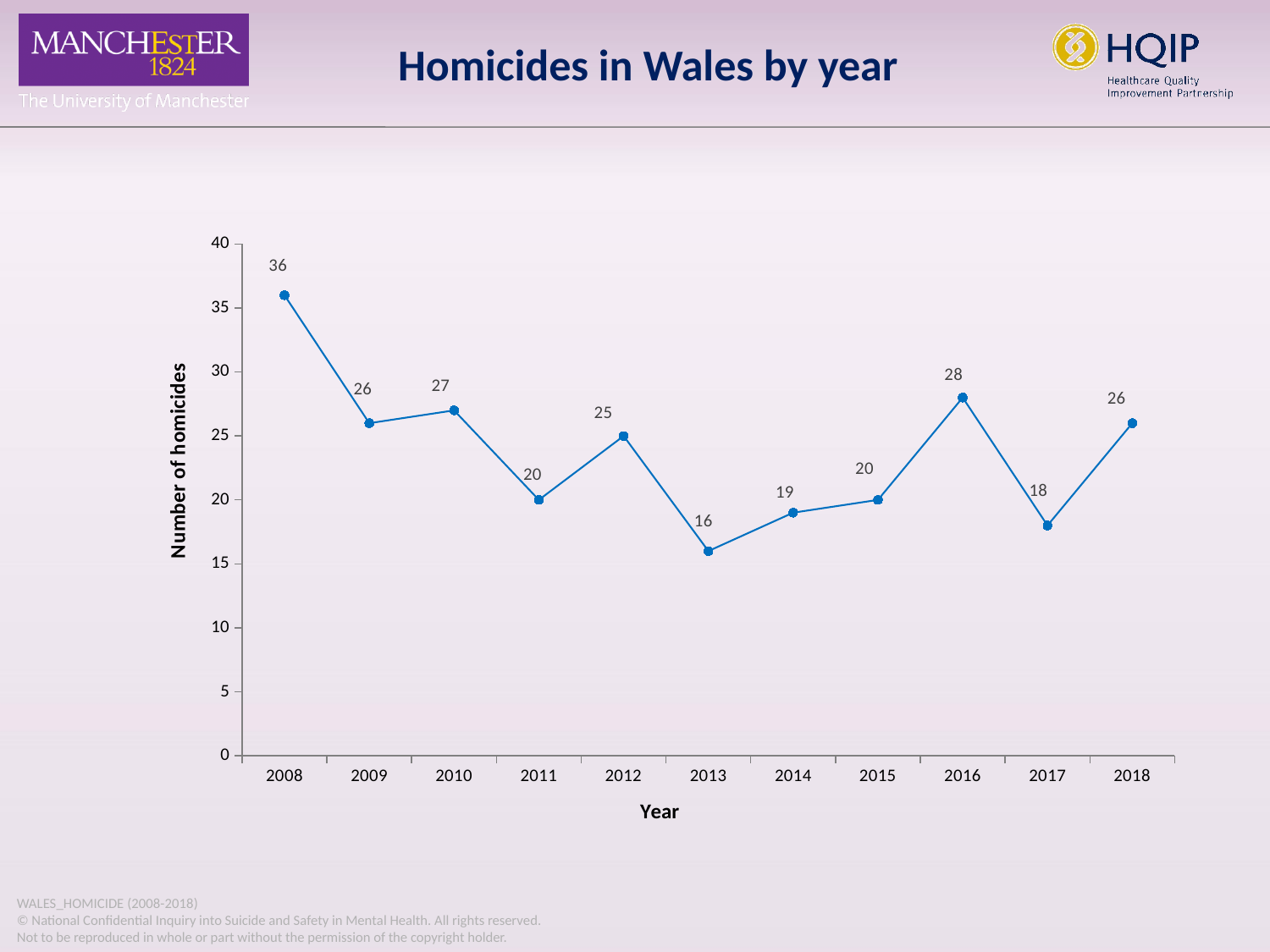
How many years are plotted on the chart? 11 Which year has the lowest number of homicides? 2013 What is the number of homicides in Wales in 2016? 28 What is the number of homicides in Wales in 2008? 36 What is the difference in the number of homicides between 2008 and 2013? 20 Which year has the highest number of homicides? 2008 What is the label of the y axis? Number of homicides What is the number of homicides in Wales in 2013? 16 Which year had more homicides, 2012 or 2014? 2012 What kind of chart is shown on the slide? Line chart What is the difference in the number of homicides between 2016 and 2017? 10 Is the number of homicides in 2017 greater or less than 20? less